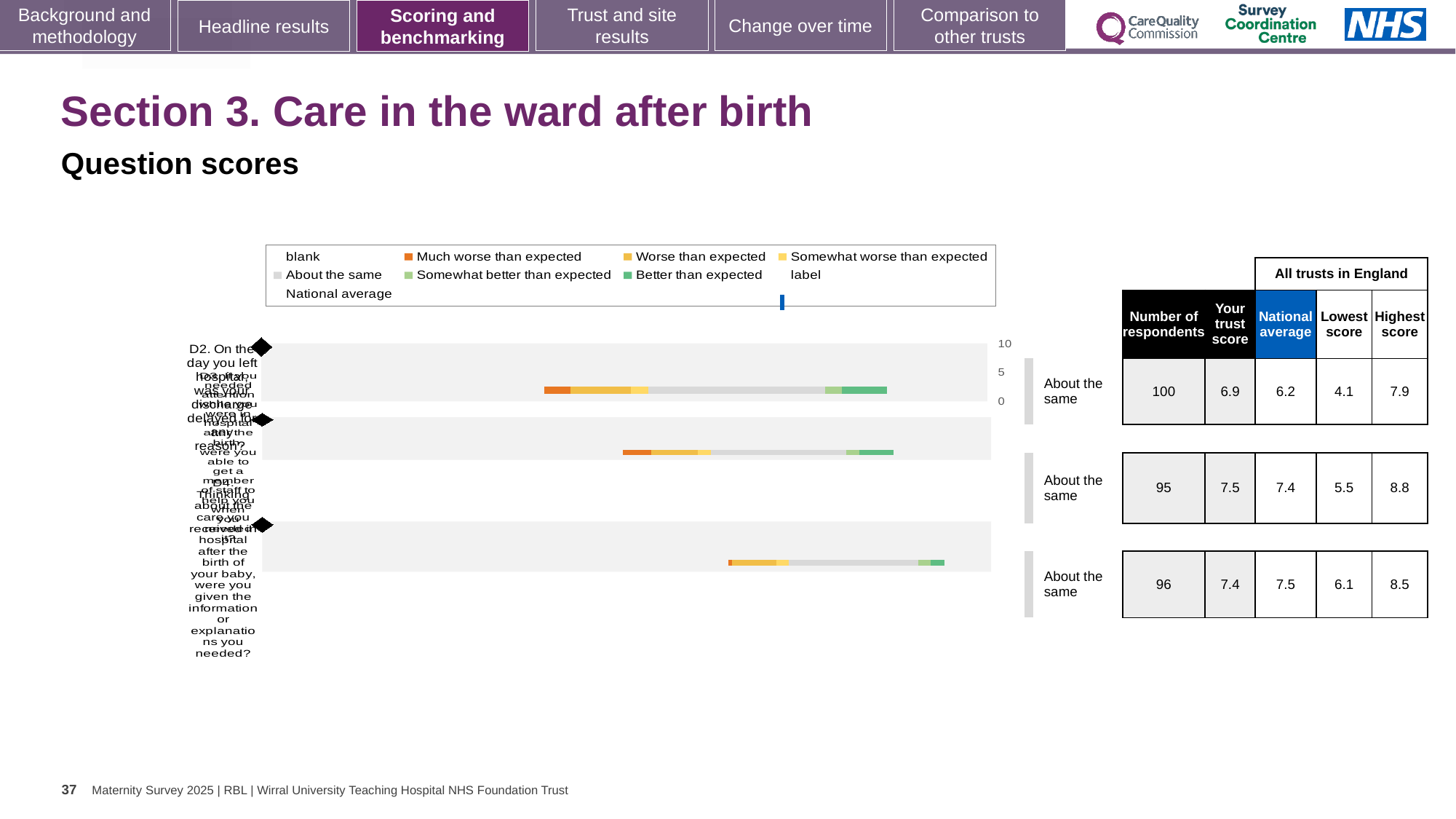
For the top row, which is larger: the trust score or the national average? the trust score (6.9) What colour does the legend use for 'Much worse than expected'? orange What colour does the legend use for 'Better than expected'? green Which row has the highest 'Your trust score'? the middle row (7.5) How many question rows (bars) are plotted in the chart? 3 What is the highest score for the bottom row of the chart? 8.5 What is the number of respondents for the top row of the chart? 100 What is 'Your trust score' for the top row of the chart? 6.9 What is the national average for the middle row of the chart? 7.4 Which row has the lowest 'Lowest score' value? the top row (4.1) What kind of chart is shown on the slide? bar chart What is the difference between the trust score of the middle row (7.5) and the top row (6.9)? 0.6